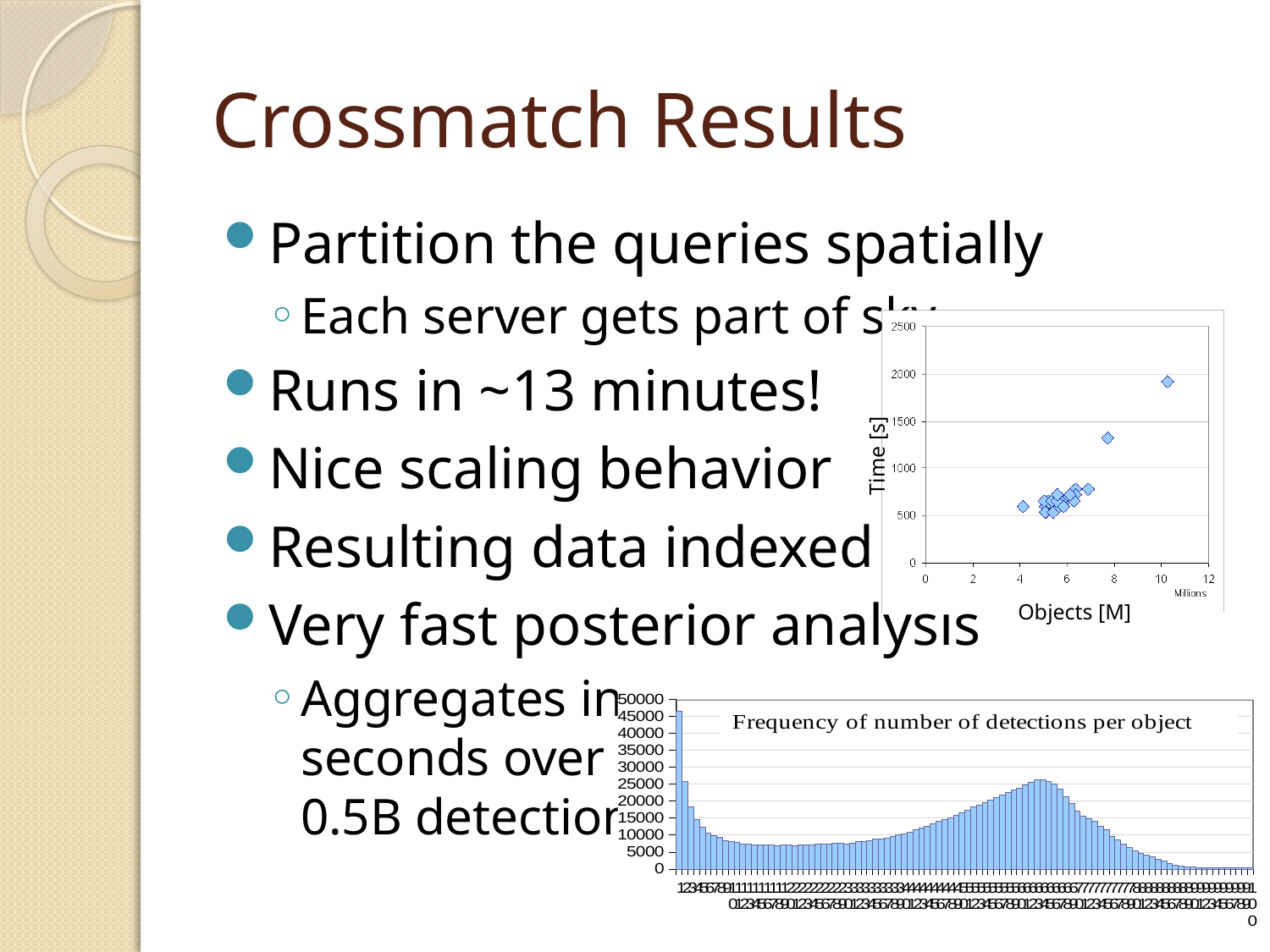
In the bottom chart (Frequency of number of detections per object), is the peak of the broad hump on the right side greater or less than 30000? less In the bottom chart (Frequency of number of detections per object), which bar is the tallest? the leftmost bar In the scatter chart in the upper right, does the time generally rise or fall as the number of objects increases? rise In the scatter chart in the upper right, are the time values of the cluster of points between 4 and 7 million objects greater or less than 1000? less In the scatter chart in the upper right, is the time value of the rightmost point greater or less than 1500? greater What kind of chart is the chart at the bottom of the slide? bar chart What is the title of the chart at the bottom of the slide? Frequency of number of detections per object What kind of chart is the chart in the upper right of the slide (Time [s] vs Objects [M])? scatter chart In the scatter chart in the upper right, what is the label of the vertical axis? Time [s]